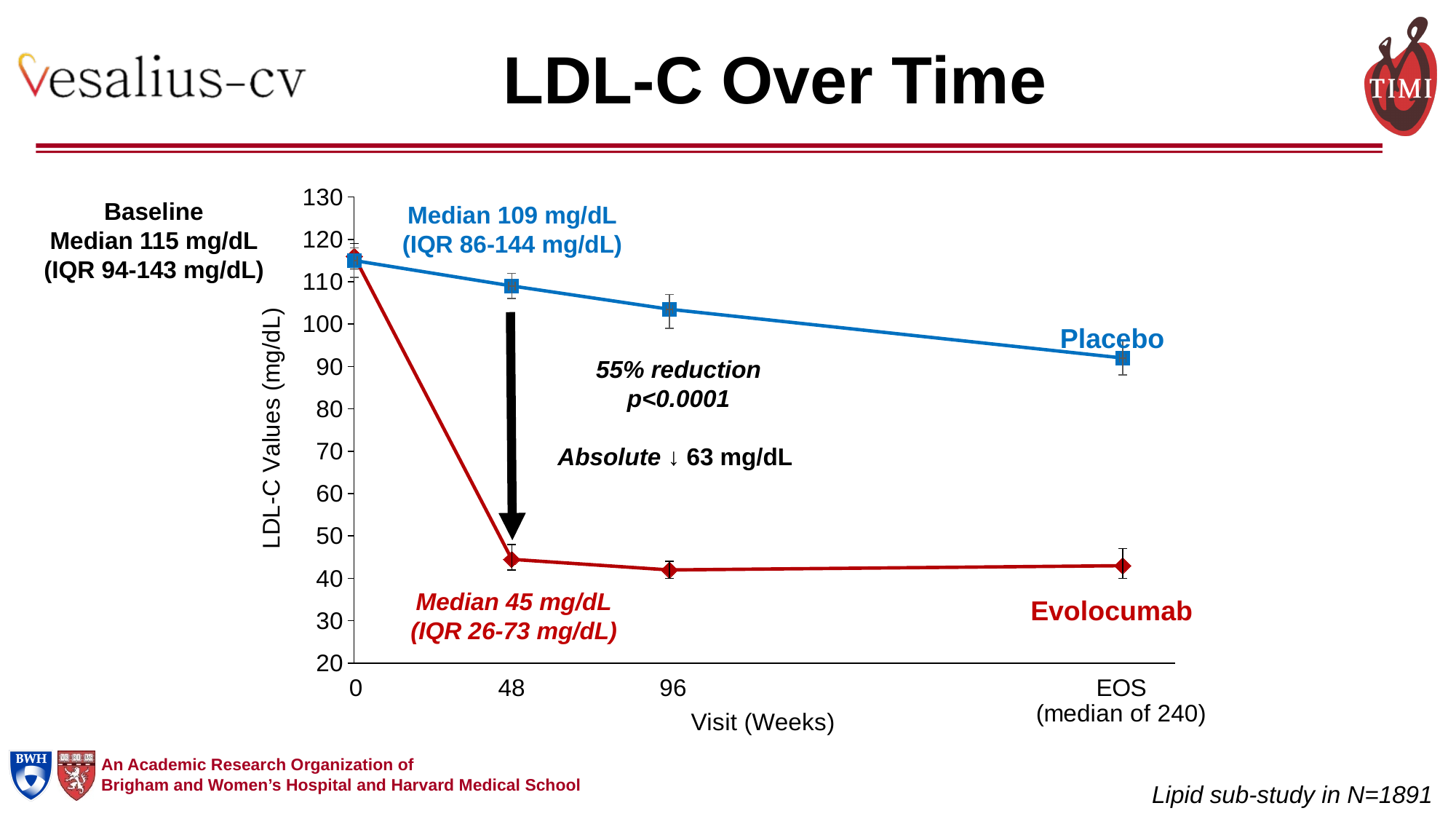
Is the Placebo value at EOS greater or less than 100? less Does the Placebo line rise or fall from week 0 to EOS? fall Is the Evolocumab value at week 96 greater or less than 50? less How many series (treatment groups) are plotted on the chart? 2 What absolute reduction in LDL-C is annotated on the chart? 63 mg/dL What is the baseline median LDL-C value? 115 mg/dL What kind of chart is shown on the slide? line chart What is the median LDL-C value for Placebo at week 48? 109 mg/dL At week 48, which group has the higher LDL-C value, Placebo or Evolocumab? Placebo What is the median LDL-C value for Evolocumab at week 48? 45 mg/dL How many visit time points are shown on the x axis? 4 What is the IQR for Evolocumab at week 48? 26-73 mg/dL